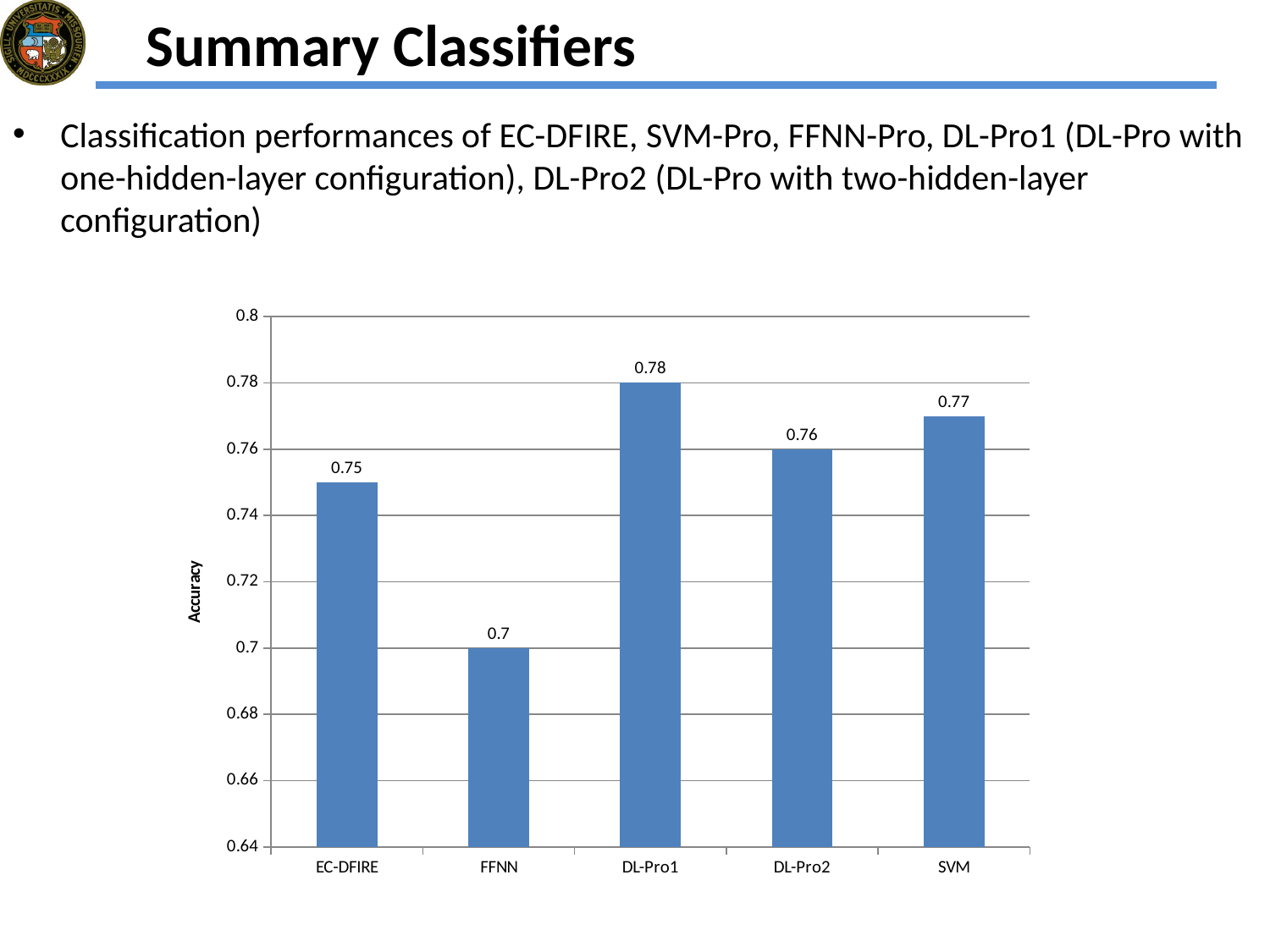
What is the difference in accuracy between SVM and EC-DFIRE? 0.02 Which has a higher accuracy, DL-Pro2 or SVM? SVM What kind of chart is shown on the slide? bar chart Which classifier has the highest accuracy? DL-Pro1 What is the accuracy value for SVM? 0.77 What is the accuracy value for FFNN? 0.7 Is the accuracy for EC-DFIRE greater or less than 0.74? greater What is the difference in accuracy between DL-Pro1 and FFNN? 0.08 Which classifier has the lowest accuracy? FFNN What is the label of the vertical axis? Accuracy How many classifiers are shown on the x axis? 5 What is the accuracy value for DL-Pro1? 0.78